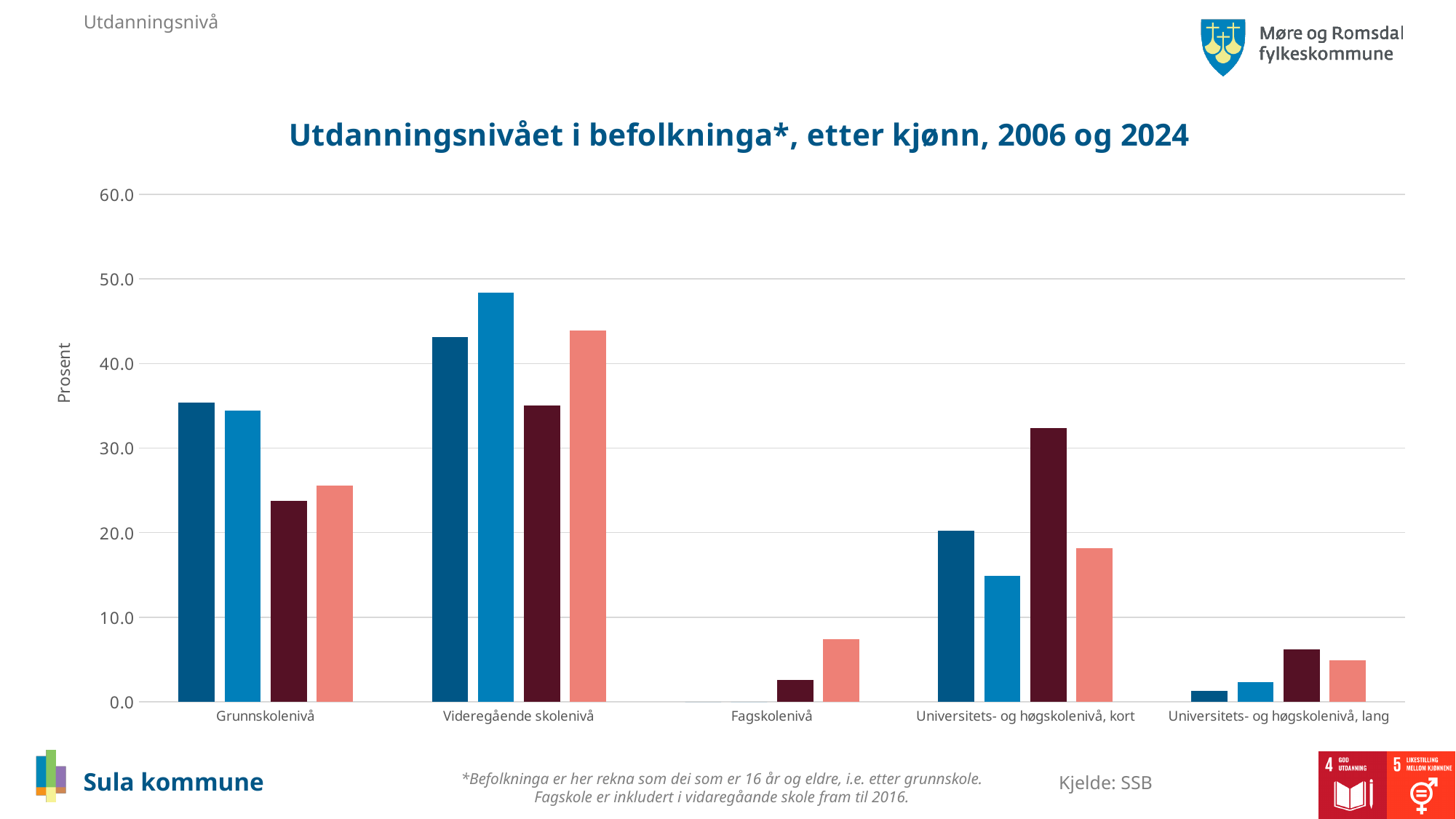
What is the title of the chart? Utdanningsnivået i befolkninga*, etter kjønn, 2006 og 2024 For Grunnskolenivå, which is larger: the dark blue bar or the dark maroon bar? the dark blue bar Is the value of the dark blue bar for Grunnskolenivå greater or less than 30? greater For which category is the dark maroon bar the highest? Videregående skolenivå Is the value of the salmon bar for Fagskolenivå greater or less than 10? less Is the value of the light blue bar for Videregående skolenivå greater or less than 40? greater How many education-level categories are shown on the x axis? 5 For Universitets- og høgskolenivå, kort, which is larger: the dark blue bar or the light blue bar? the dark blue bar What is the label on the vertical axis? Prosent For which category is the salmon bar the highest? Videregående skolenivå What kind of chart is shown on the slide? bar chart